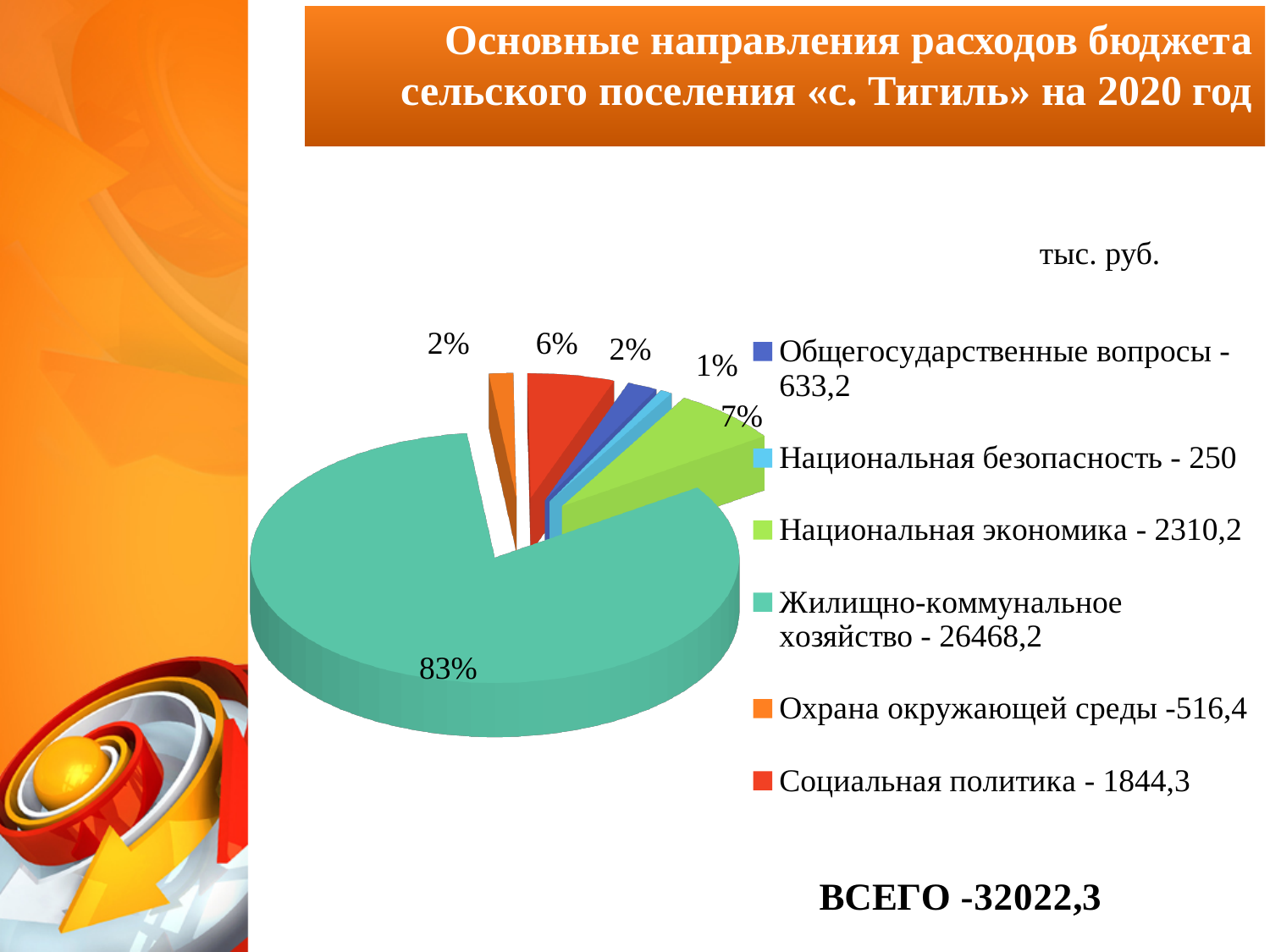
How many categories does the pie chart have? 6 Which category has the smallest share of the pie? Национальная безопасность What is the total of all expenditures shown (ВСЕГО)? 32022,3 What is the value for Охрана окружающей среды? 516,4 Which category has the largest share of the pie? Жилищно-коммунальное хозяйство What is the difference between Национальная экономика and Социальная политика? 465,9 Which is larger, Социальная политика or Национальная экономика? Национальная экономика What is the value for Жилищно-коммунальное хозяйство? 26468,2 What share of the pie does Жилищно-коммунальное хозяйство take? 83% What kind of chart is shown on the slide? pie chart What share of the pie does Национальная экономика take? 7% What is the value for Национальная экономика? 2310,2